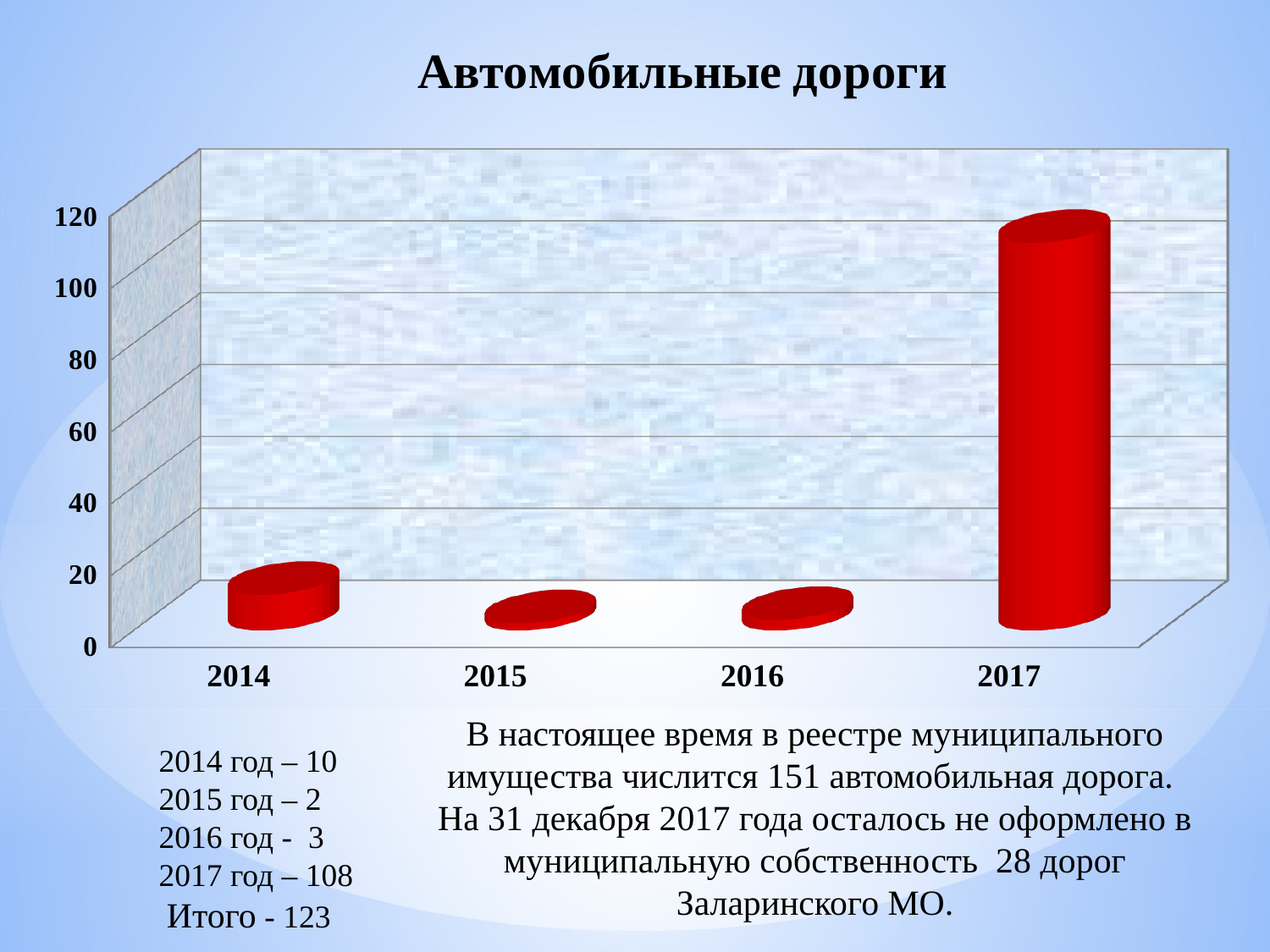
What is the title of the chart? Автомобильные дороги What is the value for 2014? 10 Which is larger, the value for 2014 or the value for 2017? 2017 Is the value for 2017 greater or less than 100? greater Which year has the highest value in the chart? 2017 What is the difference between the values for 2017 and 2014? 98 Is the value for 2014 greater or less than 20? less What is the value for 2017? 108 How many years (categories) are shown on the x axis of the chart? 4 What kind of chart is shown on the slide? bar chart What is the value for 2016? 3 Which year has the lowest value in the chart? 2015